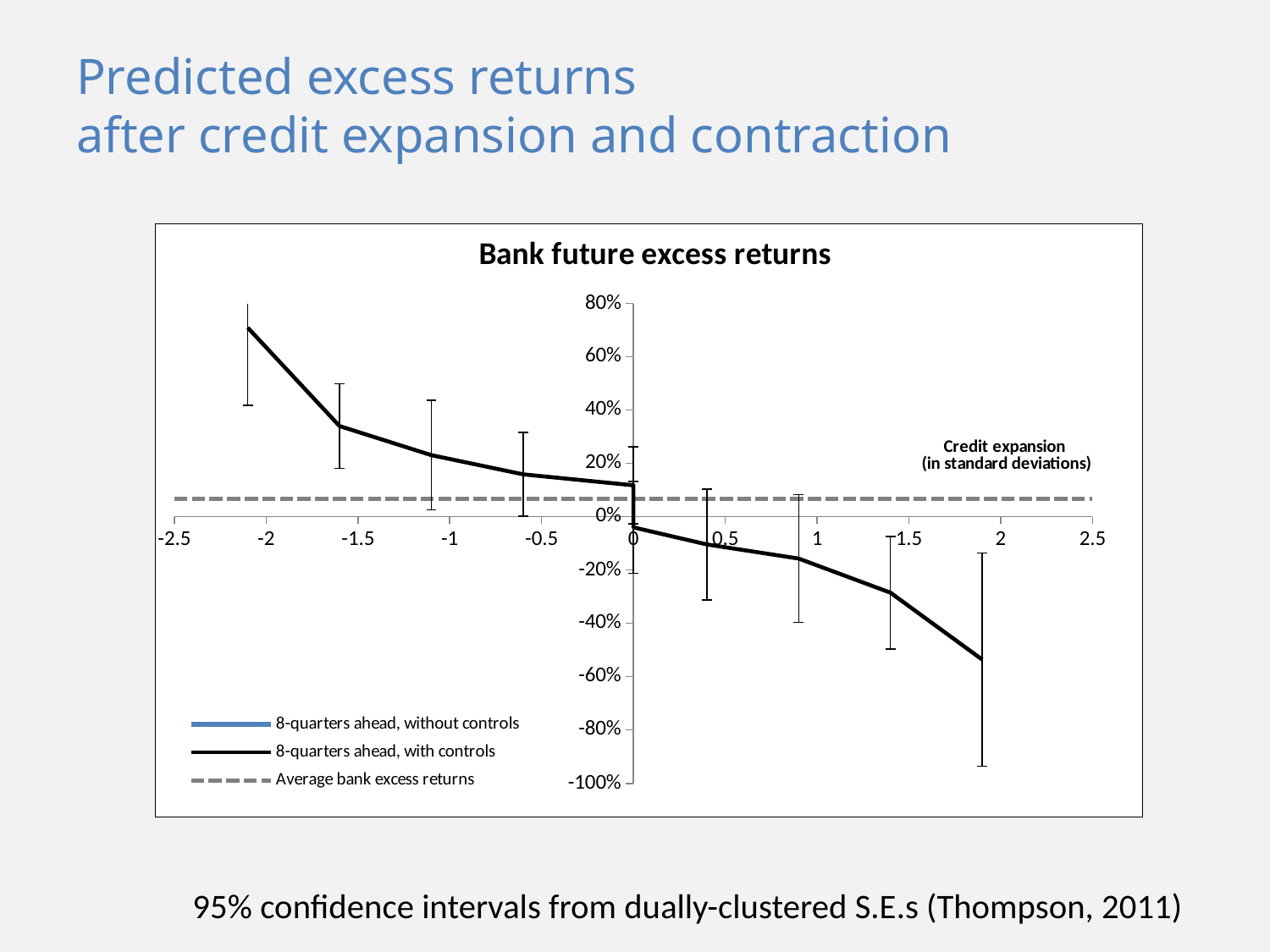
Is the value of the '8-quarters ahead, with controls' line at its rightmost point greater or less than -40%? less Is the dashed 'Average bank excess returns' line above or below 0%? above What is the title of the chart? Bank future excess returns Is the '8-quarters ahead, with controls' line lowest at the left end or the right end of the x axis? right end What label is given to the x axis of the chart? Credit expansion (in standard deviations) Is the '8-quarters ahead, with controls' line highest at the left end or the right end of the x axis? left end Does the '8-quarters ahead, with controls' line rise or fall as credit expansion increases along the x axis? fall Is the value of the '8-quarters ahead, with controls' line at its leftmost point greater or less than 60%? greater What kind of chart is shown on the slide? line chart Which is larger for the '8-quarters ahead, with controls' line: the value near a credit expansion of -2 or the value near a credit expansion of 2? the value near -2 How many series does the chart's legend list? 3